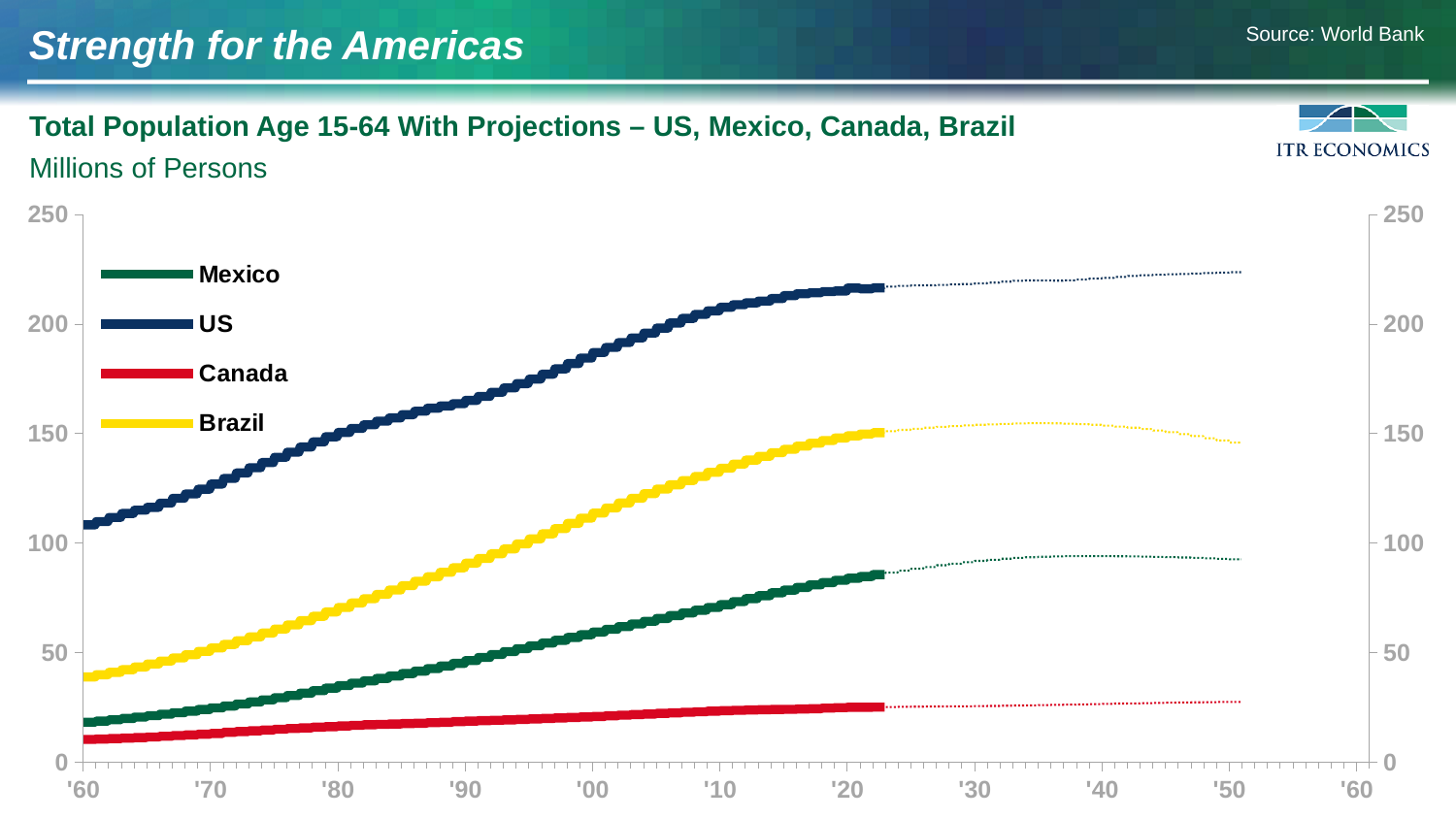
Is the value for Canada in '20 greater or less than 50? less Which series has the highest values throughout the chart? US Does the US line rise or fall from '60 (1960) to '20? rise Is the value for the US in '20 greater or less than 200? greater Which series has the lowest values throughout the chart? Canada What unit of measure is stated for the chart? Millions of Persons Is the value for Brazil in '60 (1960) greater or less than 50? less How many series does the legend list? 4 What is the source cited for the chart data? World Bank What kind of chart is shown on the slide? line chart Which is larger in '20, the value for Mexico or the value for Canada? Mexico